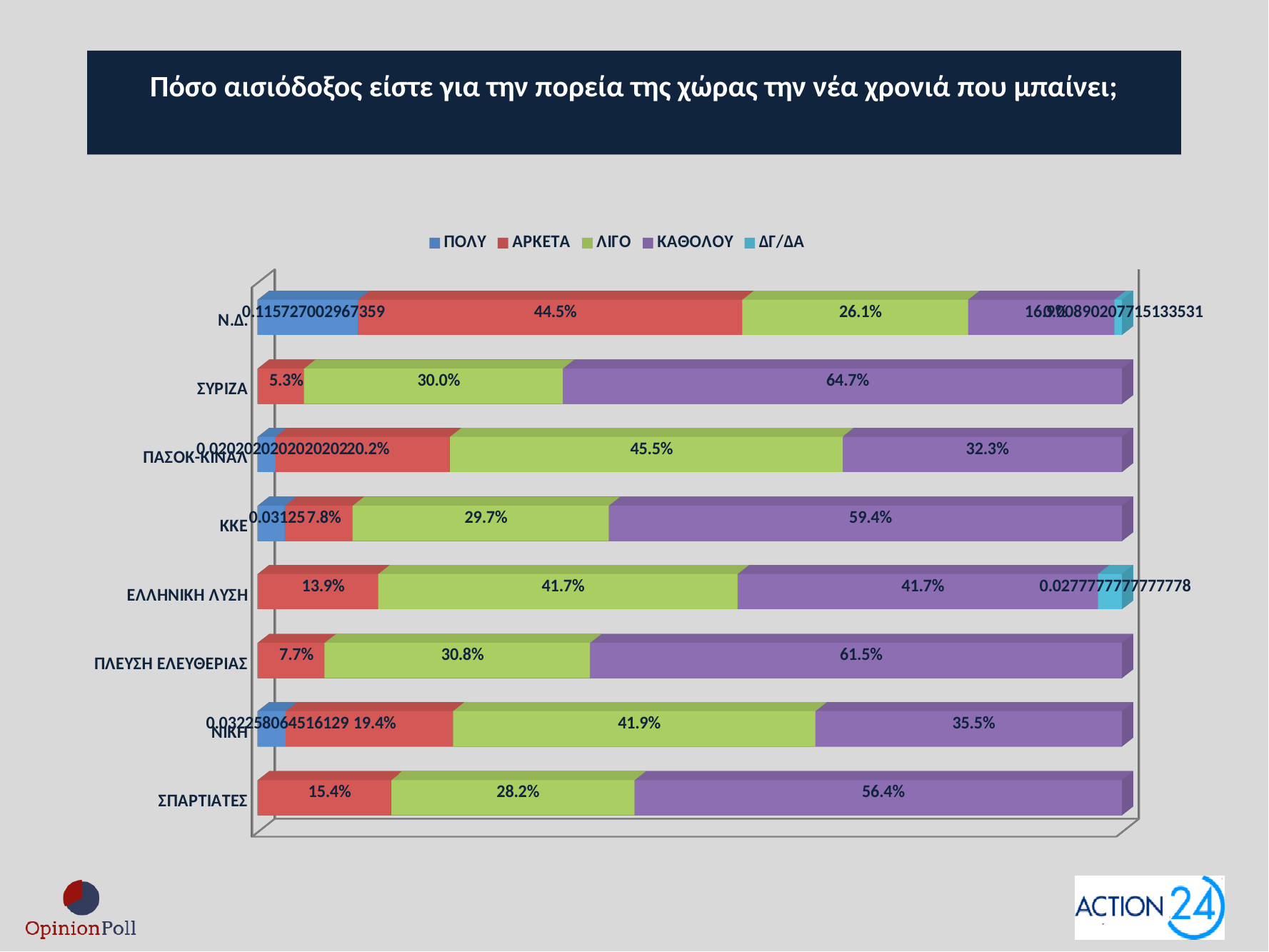
What is the ΑΡΚΕΤΑ value for ΣΠΑΡΤΙΑΤΕΣ? 15.4% What is the ΑΡΚΕΤΑ value for Ν.Δ.? 44.5% What is the difference between the ΚΑΘΟΛΟΥ values for ΣΥΡΙΖΑ and ΠΛΕΥΣΗ ΕΛΕΥΘΕΡΙΑΣ? 3.2% Which category has the highest ΑΡΚΕΤΑ value? Ν.Δ. Which category has the highest ΚΑΘΟΛΟΥ value? ΣΥΡΙΖΑ Which is larger: the ΛΙΓΟ value for ΝΙΚΗ or the ΛΙΓΟ value for ΚΚΕ? ΝΙΚΗ What is the ΚΑΘΟΛΟΥ value for ΣΥΡΙΖΑ? 64.7% How many categories (parties) are shown on the chart? 8 Which category has the lowest ΚΑΘΟΛΟΥ value? Ν.Δ. What is the ΛΙΓΟ value for ΠΑΣΟΚ-ΚΙΝΑΛ? 45.5% What kind of chart is shown on the slide? Stacked bar chart How many series does the legend list? 5